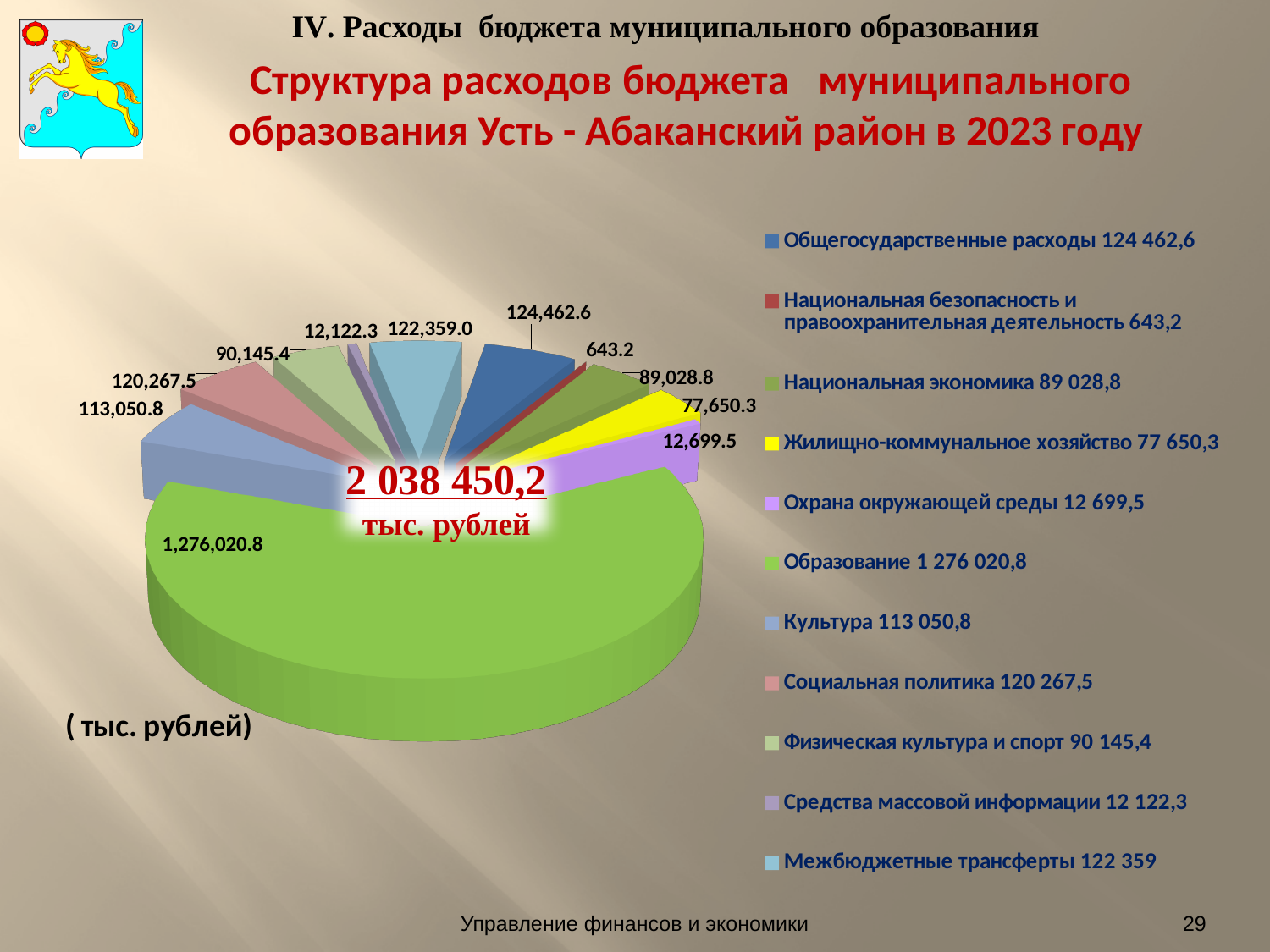
What is the difference between the values for Социальная политика (120,267.5) and Культура (113,050.8)? 7,216.7 What is the difference between the values for Общегосударственные расходы (124,462.6) and Межбюджетные трансферты (122,359.0)? 2,103.6 What value is labelled on the Межбюджетные трансферты slice? 122,359.0 What value is labelled on the Охрана окружающей среды slice? 12,699.5 Which category has the largest slice in the pie chart? Образование What total amount is printed in the centre of the pie chart? 2 038 450,2 тыс. рублей What kind of chart is shown on the slide? pie chart Which category has the smallest slice in the pie chart? Национальная безопасность и правоохранительная деятельность How many categories (slices) does the pie chart have? 11 What value is labelled on the Жилищно-коммунальное хозяйство slice? 77,650.3 What value is labelled on the Образование slice of the pie chart? 1,276,020.8 Which is larger, the value for Культура or the value for Социальная политика? Социальная политика